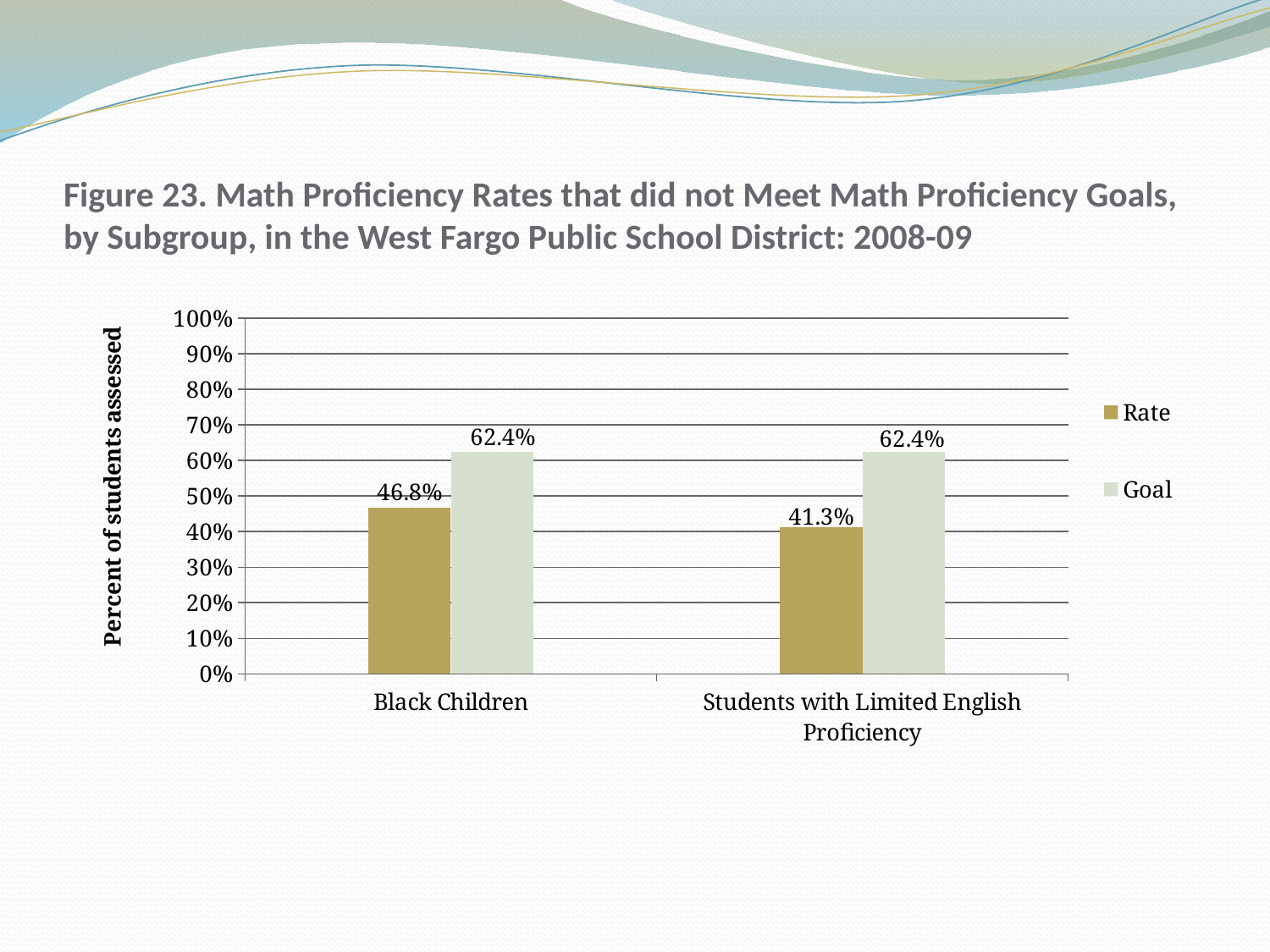
What is the label of the y axis? Percent of students assessed What is the Rate value for Black Children? 46.8% What is the difference between the Goal and the Rate for Students with Limited English Proficiency? 21.1% What is the Goal value for Black Children? 62.4% What is the difference between the Rate for Black Children and the Rate for Students with Limited English Proficiency? 5.5% How many subgroups are shown on the x axis? 2 What is the Rate value for Students with Limited English Proficiency? 41.3% What kind of chart is shown on the slide? Bar chart What is the difference between the Goal and the Rate for Black Children? 15.6% How many series does the legend list? 2 Which subgroup has the lowest Rate value? Students with Limited English Proficiency Which subgroup has the higher Rate value? Black Children